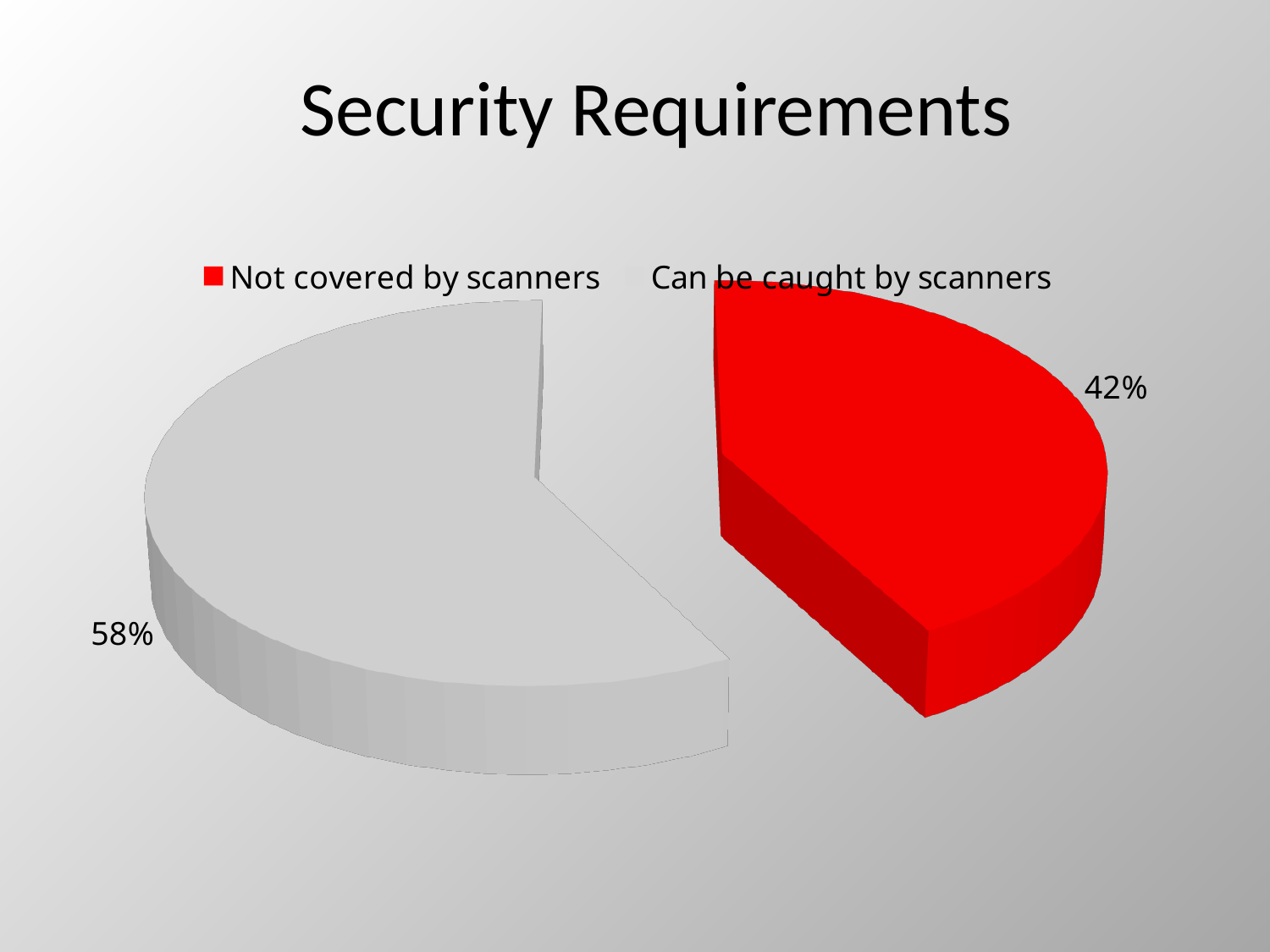
Which is larger: the "Not covered by scanners" slice or the "Can be caught by scanners" slice? Can be caught by scanners What colour is the "Not covered by scanners" slice? red What is the difference in percentage points between the "Can be caught by scanners" slice and the "Not covered by scanners" slice? 16 How many entries does the legend list? 2 Which slice is the largest? Can be caught by scanners What kind of chart is shown on the slide? pie chart Which slice is the smallest? Not covered by scanners How many slices does the pie chart have? 2 What is the title of the chart? Security Requirements What share of the pie is labelled "Can be caught by scanners"? 58% What share of the pie is labelled "Not covered by scanners"? 42%